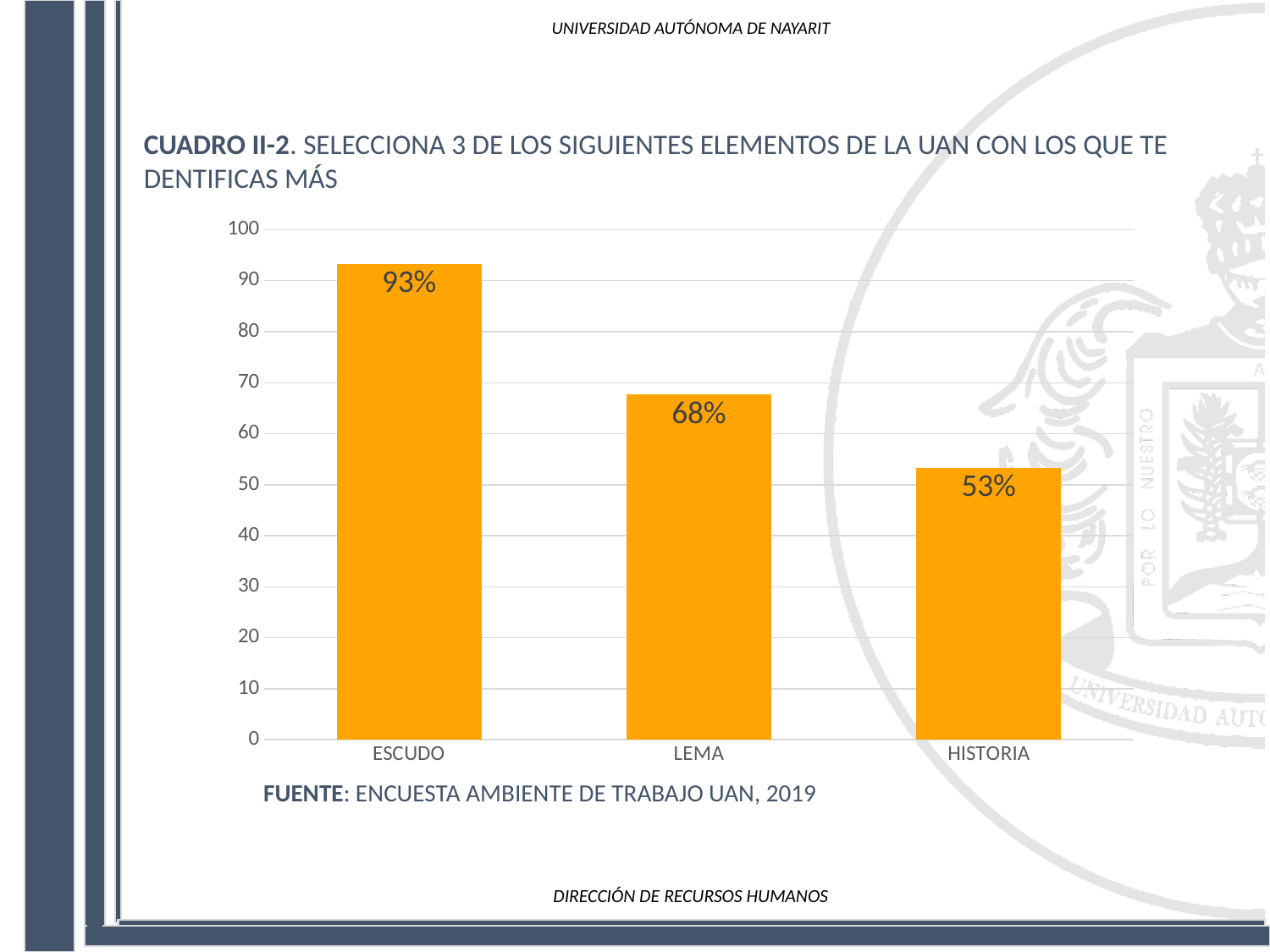
How many categories are shown on the x axis? 3 What is the difference between the values for ESCUDO and LEMA? 25% Which is larger, the value for LEMA or the value for HISTORIA? LEMA What kind of chart is shown on the slide? bar chart Is the value for HISTORIA greater or less than 60? less What is the value for LEMA? 68% What is the value for HISTORIA? 53% What is the difference between the values for LEMA and HISTORIA? 15% Do the values rise or fall from left to right along the x axis? fall What is the value for ESCUDO? 93% Which category has the lowest value? HISTORIA Which category has the highest value? ESCUDO